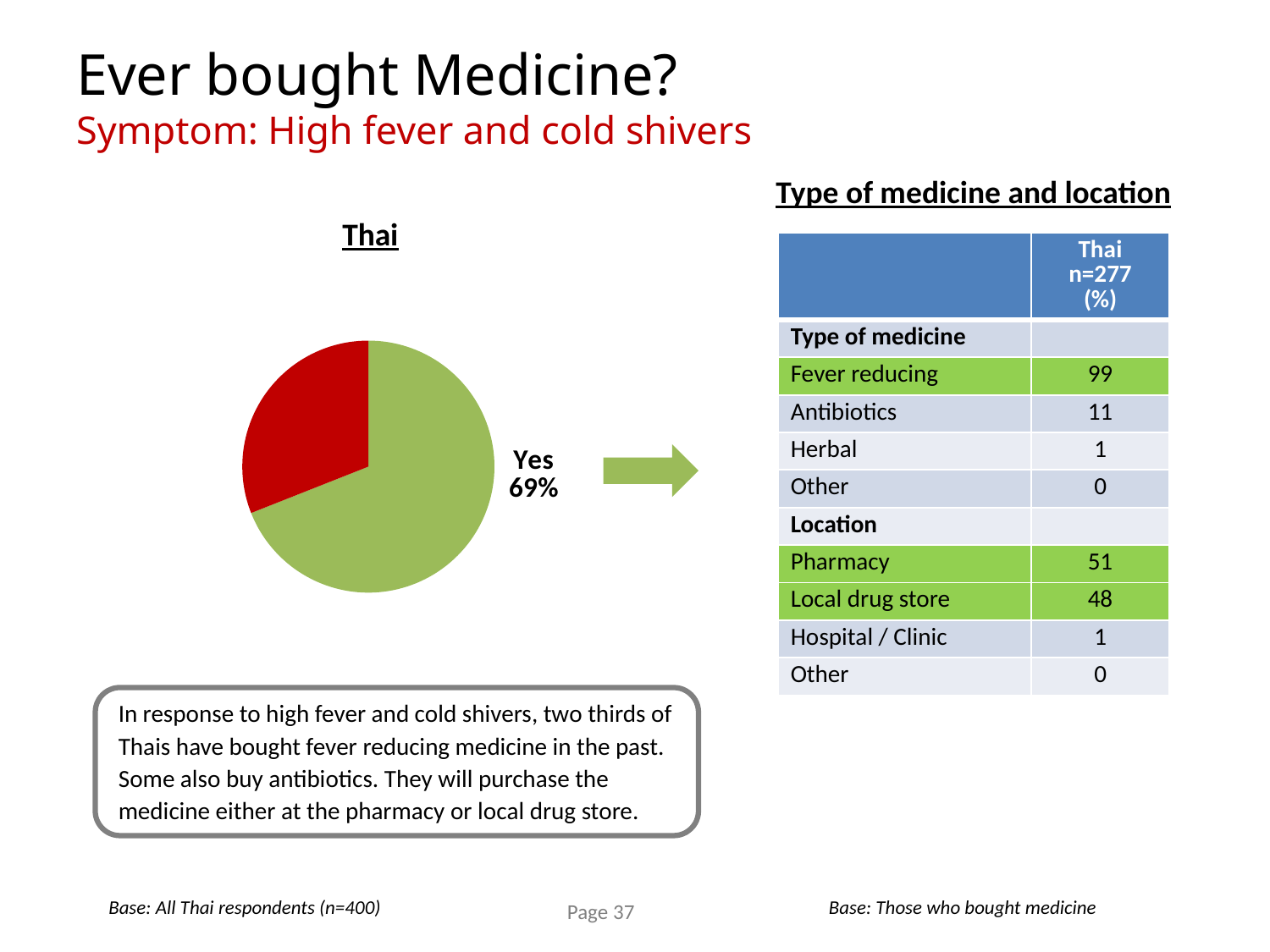
How many slices does the pie chart have? 2 Which slice of the pie chart has a printed data label? Yes What kind of chart is shown under the heading "Thai"? Pie chart What colour is the "Yes" slice in the pie chart? Green In the pie chart, which slice is larger, the green "Yes" slice or the red slice? The green "Yes" slice In the pie chart, what share of Thai respondents answered "Yes"? 69% What is the title of the pie chart? Thai